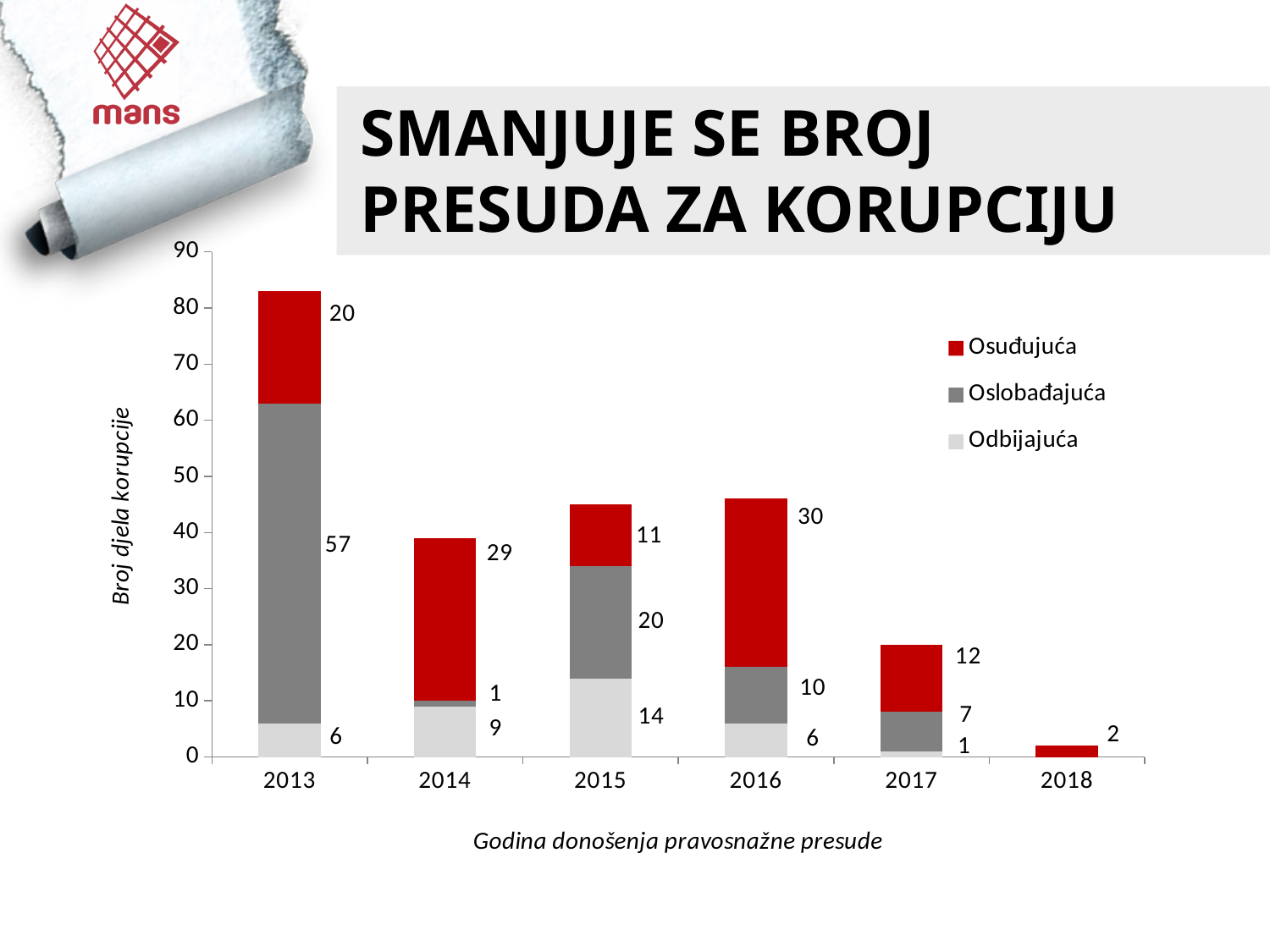
What is the value for Oslobađajuća in 2013? 57 What type of chart is shown on the slide? stacked bar chart How many series does the legend list? 3 What is the difference between the Osuđujuća values for 2014 and 2017? 17 What is the total of the stacked bar for 2013? 83 How many years are shown on the x axis? 6 Which is larger, the Oslobađajuća value in 2015 or in 2016? 2015 What is the value for Odbijajuća in 2015? 14 In which year is the Osuđujuća value highest? 2016 In which year is the Osuđujuća value lowest? 2018 What is the value for Osuđujuća in 2016? 30 Which series is shown in red in the legend? Osuđujuća